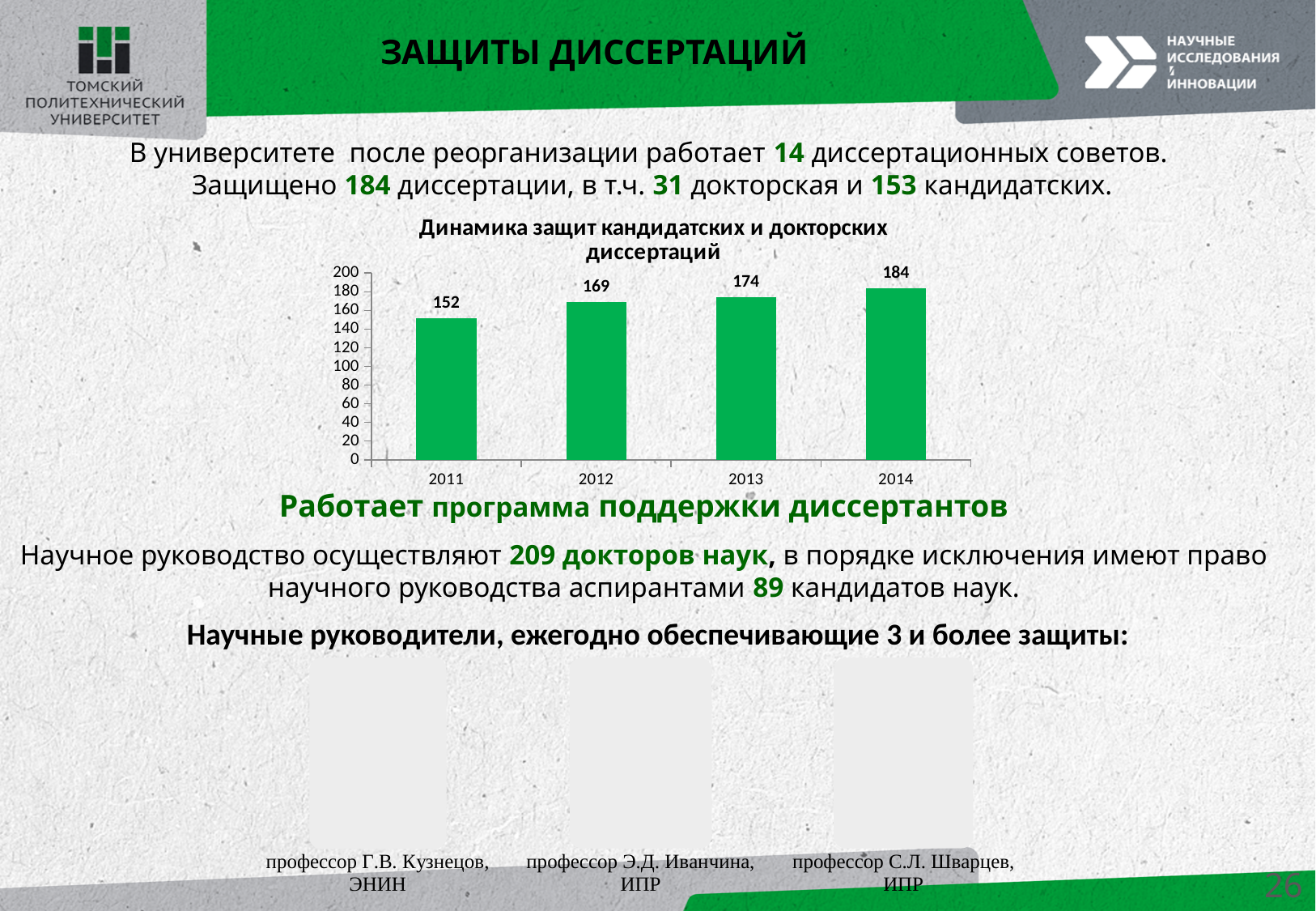
Which year has the lowest value in the chart? 2011 What is the value for 2011 in the chart? 152 Do the values rise or fall from 2011 to 2014? rise What is the difference between the values for 2012 and 2011? 17 What kind of chart is shown on the slide? bar chart What is the value for 2014 in the chart? 184 Which year has the highest value in the chart? 2014 How many years are shown on the x axis of the chart? 4 Is the value for 2012 greater or less than 160? greater What is the value for 2013 in the chart? 174 Which is larger, the value for 2012 or the value for 2013? 2013 What is the difference between the values for 2014 and 2011? 32